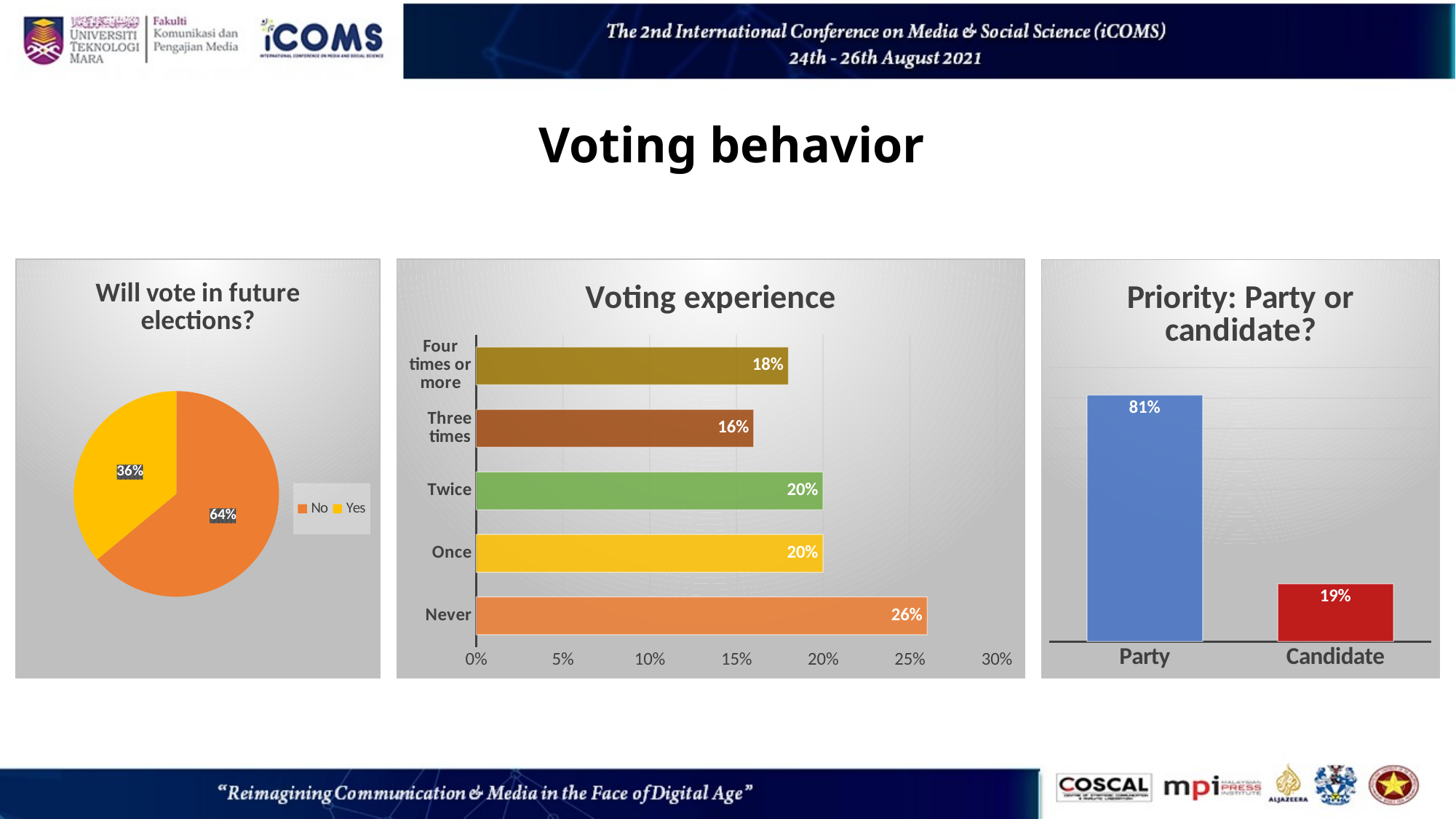
In the 'Voting experience' chart, what is the difference between Never and Four times or more? 8% What kind of chart is the 'Voting experience' chart? Bar chart In the 'Priority: Party or candidate?' chart, what is the difference between Party and Candidate? 62% In the 'Will vote in future elections?' chart, what share of respondents answered No? 64% In the 'Priority: Party or candidate?' chart, what is the value for Party? 81% In the 'Will vote in future elections?' chart, what share of respondents answered Yes? 36% In the 'Voting experience' chart, which category has the lowest value? Three times In the 'Voting experience' chart, what is the value for Three times? 16% What kind of chart is the 'Will vote in future elections?' chart? Pie chart In the 'Voting experience' chart, which category has the highest value? Never How many categories does the 'Voting experience' chart show? 5 In the 'Voting experience' chart, what is the value for Never? 26%